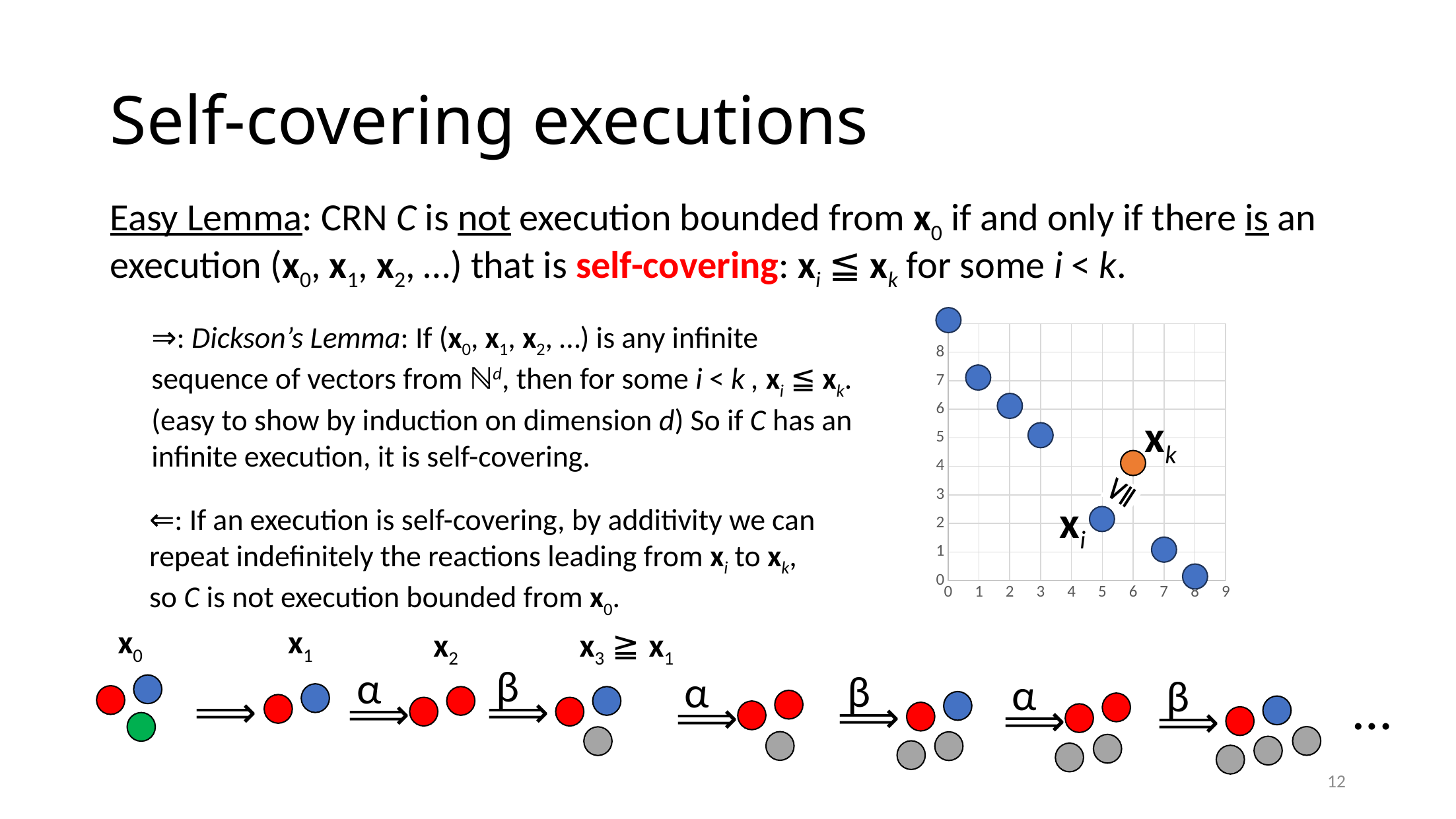
In the scatter chart, what is the y value of the point labelled x_k? 4 In the scatter chart, what is the y value of the point labelled x_i? 2 In the scatter chart, at which x value is the point with the lowest y value? 8 What kind of chart is shown on the right of the slide? scatter chart In the scatter chart, what is the difference in y value between x_k and x_i? 2 In the scatter chart, is the y value of the point at x = 1 greater or less than 5? greater In the scatter chart, do the y values generally rise or fall as x increases? fall In the scatter chart, what is the x value of the point labelled x_k? 6 In the scatter chart, which point has the larger y value, x_i or x_k? x_k In the scatter chart, what is the x value of the point labelled x_i? 5 How many points are plotted in the scatter chart? 8 In the scatter chart, what colour is the point labelled x_k? orange